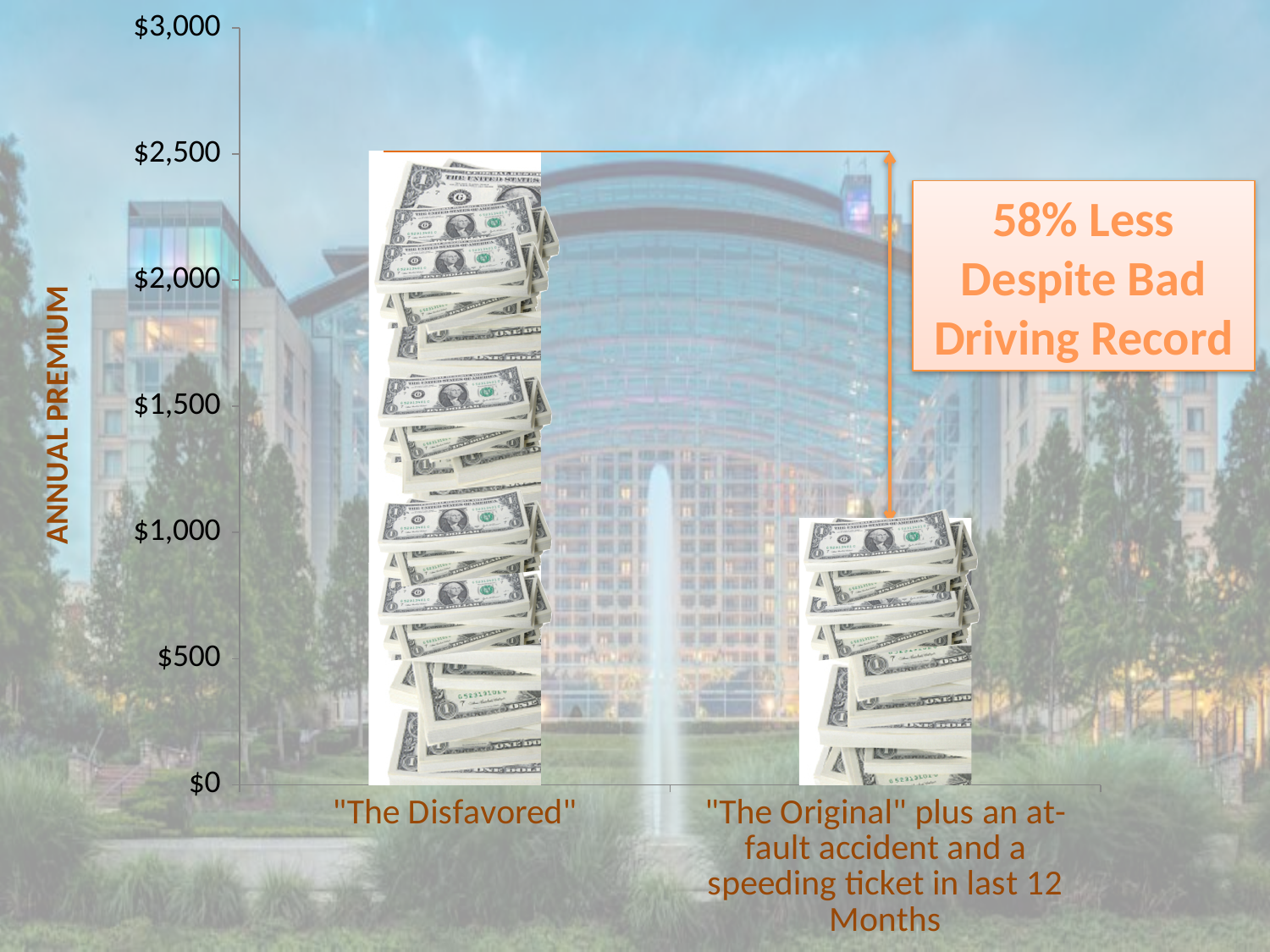
Is the annual premium for "The Original" plus an at-fault accident and a speeding ticket greater or less than $500? greater Which category has the lower annual premium? "The Original" plus an at-fault accident and a speeding ticket in last 12 Months According to the callout on the chart, by what percentage is the premium lower despite a bad driving record? 58% Less Is the annual premium for "The Disfavored" greater or less than $3,000? less Is the annual premium for "The Original" plus an at-fault accident and a speeding ticket greater or less than $1,500? less What is the highest value shown on the vertical axis? $3,000 What is the label on the vertical axis of the chart? ANNUAL PREMIUM Which is larger: the premium for "The Disfavored" or the premium for "The Original" with a bad driving record? "The Disfavored" What kind of chart is shown on the slide? bar chart Which category has the higher annual premium? "The Disfavored" How many bars (categories) does the chart show? 2